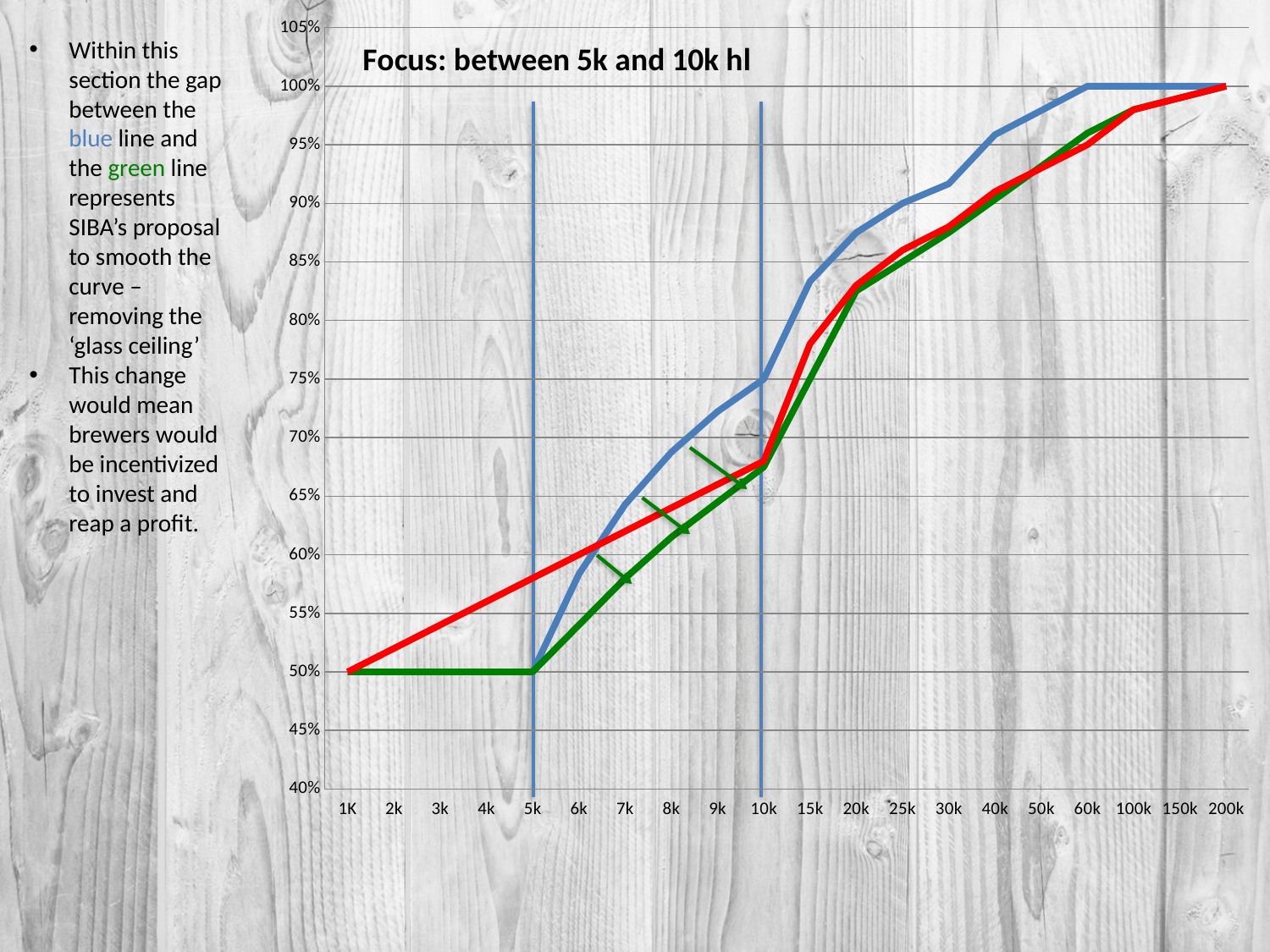
Is the value of the green line at 7k greater or less than 60%? less What is the value of the blue line at 5k? 50% Does the blue line rise or fall between 5k and 60k? Rises Is the value of the blue line at 15k greater or less than 80%? greater What is the value of the green line at 3k? 50% Is the value of the green line at 30k greater or less than 90%? less At 8k, which line has the higher value, the blue line or the green line? Blue line What is the value of the blue line at 200k? 100% How many categories are labelled along the x axis of the chart? 20 What kind of chart is shown on the slide? Line chart What is the title of the chart? Focus: between 5k and 10k hl